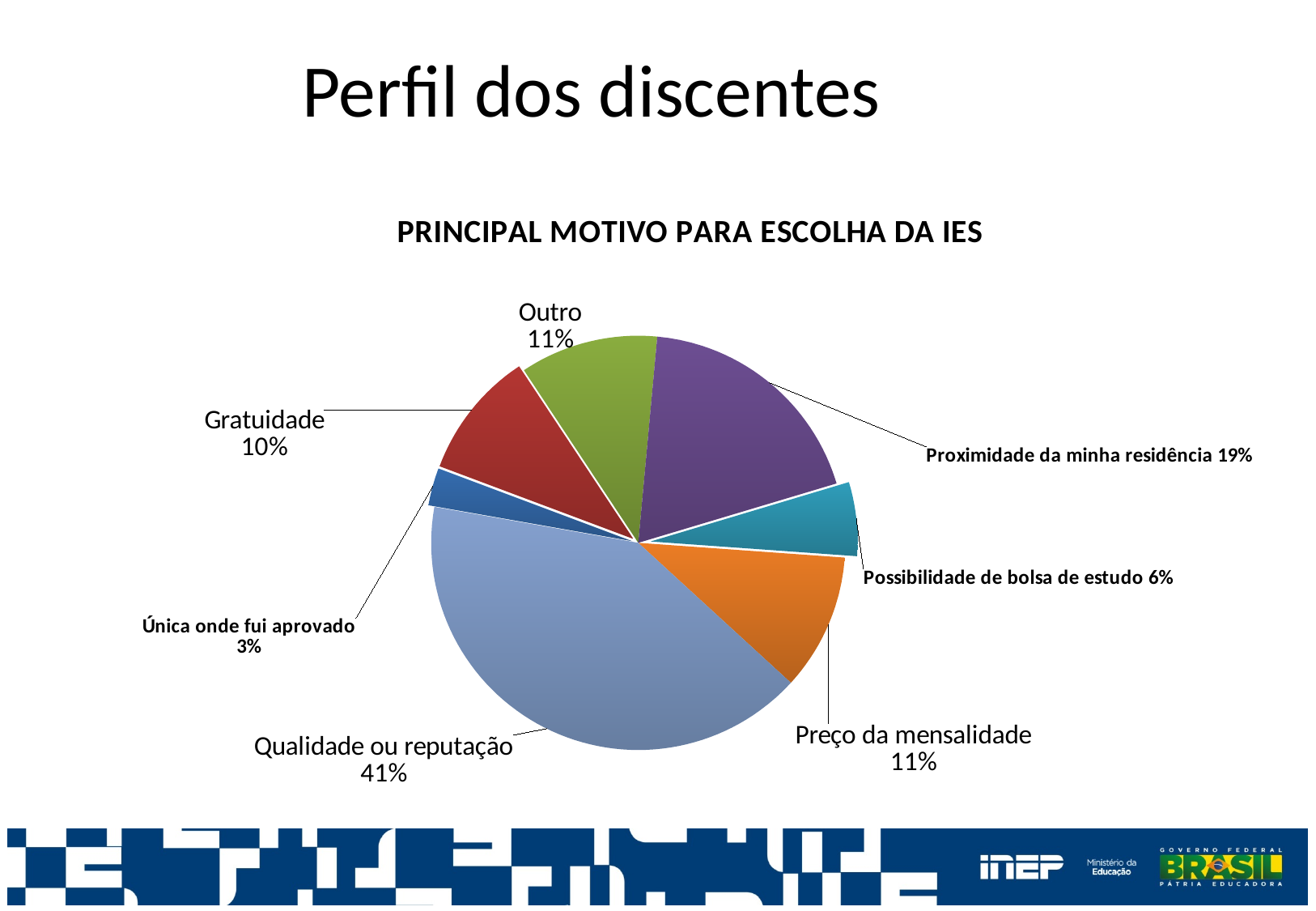
What is the value for 'Gratuidade'? 10% What is the value for 'Proximidade da minha residência'? 19% How many slices does the pie chart have? 7 What is the value for 'Preço da mensalidade'? 11% What is the title of the chart? PRINCIPAL MOTIVO PARA ESCOLHA DA IES What kind of chart is shown on the slide? Pie chart Which is larger, 'Gratuidade' or 'Possibilidade de bolsa de estudo'? Gratuidade What is the difference in percentage points between 'Qualidade ou reputação' and 'Proximidade da minha residência'? 22 Which category has the smallest share of the pie? Única onde fui aprovado Which category has the largest share of the pie? Qualidade ou reputação What is the value for 'Possibilidade de bolsa de estudo'? 6% What share of the pie is 'Qualidade ou reputação'? 41%